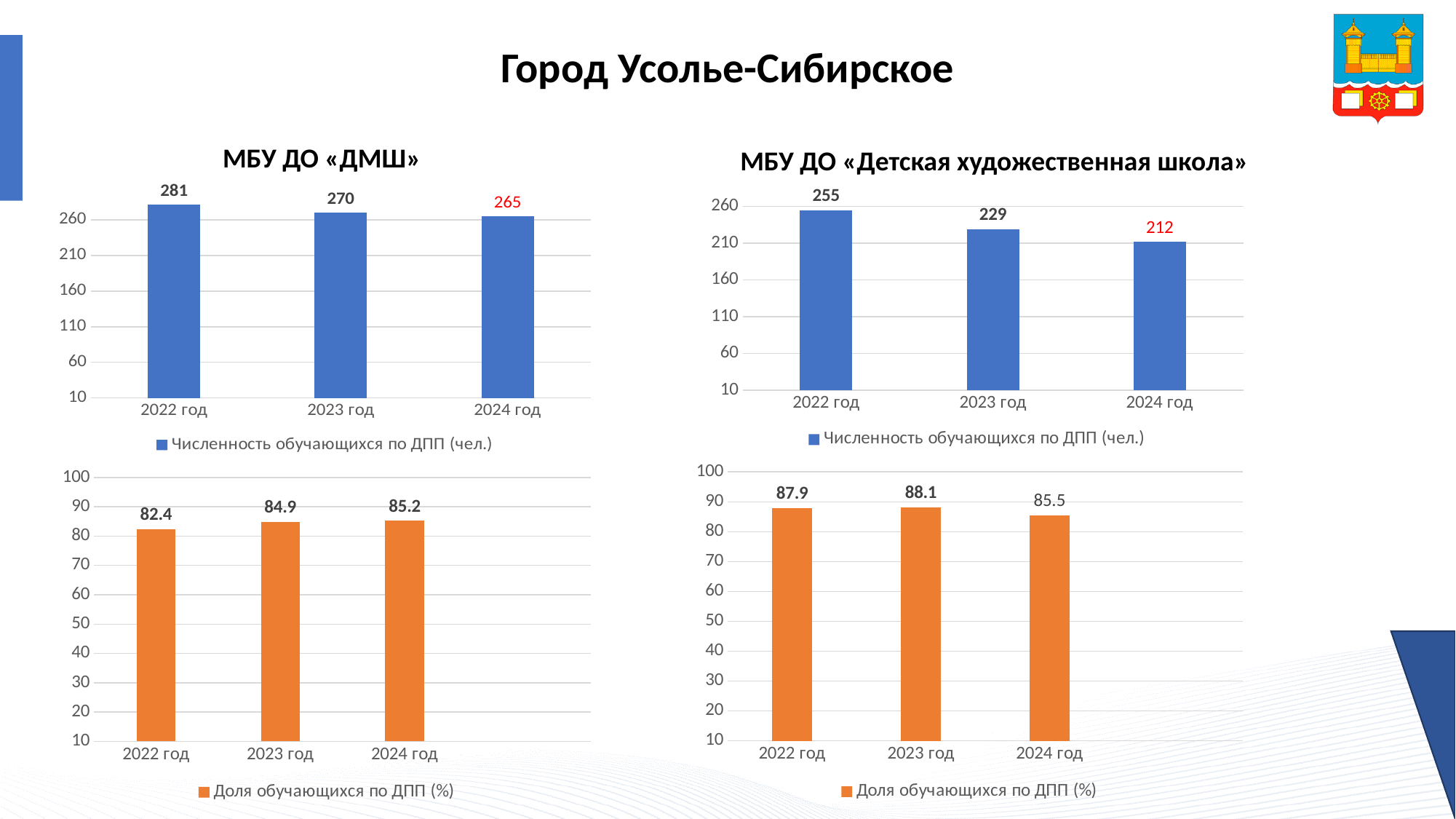
In the bottom-right chart (Доля обучающихся по ДПП (%)), what is the value for 2024 год? 85.5 In the top-right chart titled «МБУ ДО «Детская художественная школа»», what is the value for 2023 год? 229 In the bottom-right chart (Доля обучающихся по ДПП (%)), which is larger, the value for 2022 год or 2024 год? 2022 год In the top-right chart titled «МБУ ДО «Детская художественная школа»», which year has the highest value? 2022 год In the top-right chart titled «МБУ ДО «Детская художественная школа»», do the values rise or fall from 2022 год to 2024 год? fall In the top-left chart titled «МБУ ДО «ДМШ»», which year has the lowest value? 2024 год In the bottom-left chart (Доля обучающихся по ДПП (%)), what is the value for 2023 год? 84.9 In the bottom-left chart (Доля обучающихся по ДПП (%)), do the values rise or fall from 2022 год to 2024 год? rise What type of chart is the bottom-right chart? bar chart In the top-left chart titled «МБУ ДО «ДМШ»», what is the difference between the 2022 год and 2024 год values? 16 In the top-left chart titled «МБУ ДО «ДМШ»», what is the value for 2022 год? 281 How many bars are in the top-left chart titled «МБУ ДО «ДМШ»»? 3